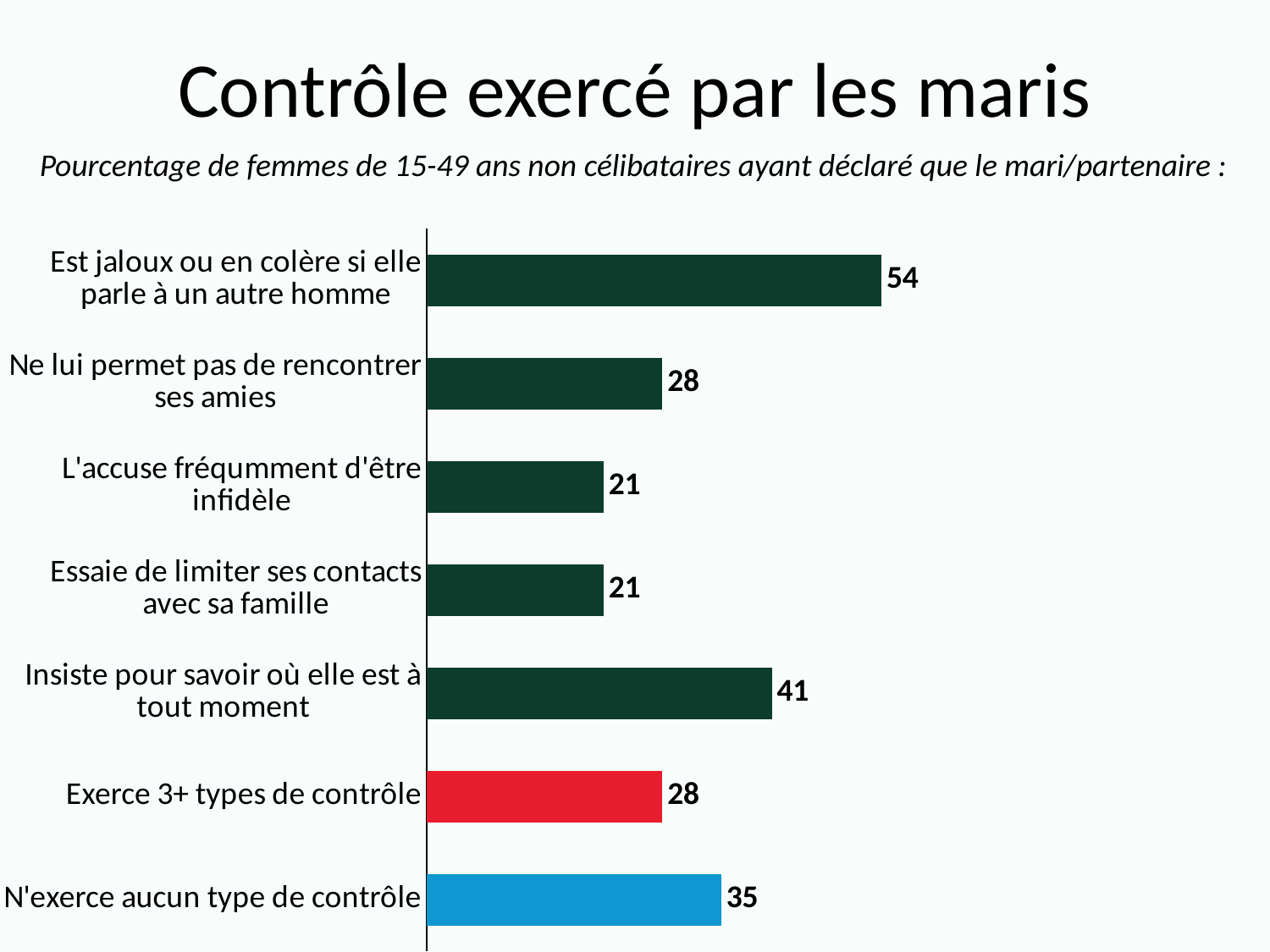
Which is larger: the value for "Ne lui permet pas de rencontrer ses amies" or the value for "L'accuse fréqumment d'être infidèle"? Ne lui permet pas de rencontrer ses amies What is the title of the chart? Contrôle exercé par les maris What is the value for "N'exerce aucun type de contrôle"? 35 What is the value for "Est jaloux ou en colère si elle parle à un autre homme"? 54 What kind of chart is shown on the slide? Bar chart What is the difference between the values for "N'exerce aucun type de contrôle" and "Exerce 3+ types de contrôle"? 7 How many categories are shown in the chart? 7 What colour is the bar for "Exerce 3+ types de contrôle"? Red What is the value for "Exerce 3+ types de contrôle"? 28 What is the value for "Insiste pour savoir où elle est à tout moment"? 41 What is the difference between the values for "Est jaloux ou en colère si elle parle à un autre homme" and "Insiste pour savoir où elle est à tout moment"? 13 Which category has the highest value? Est jaloux ou en colère si elle parle à un autre homme